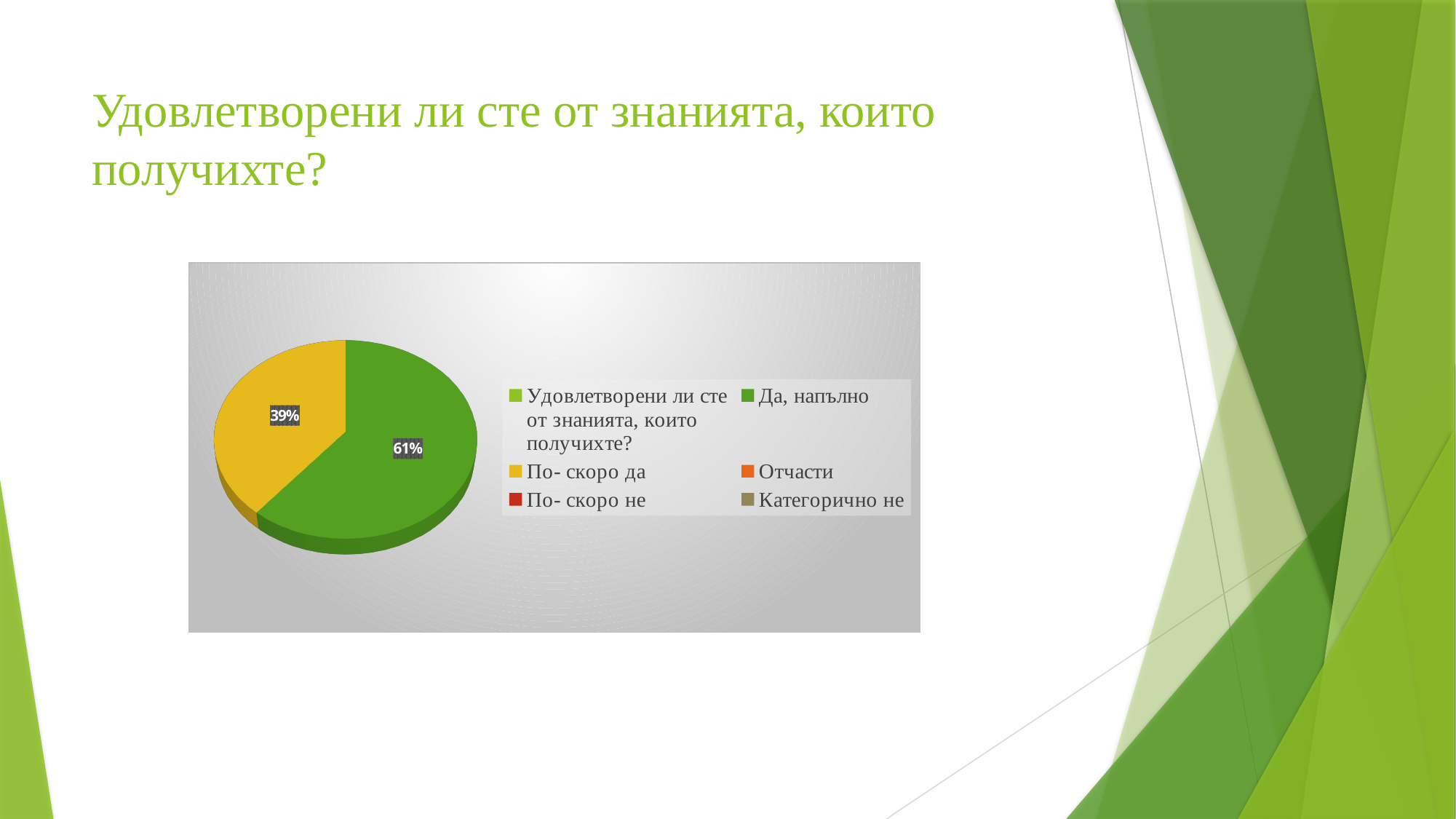
What is the difference in percentage points between the "Да, напълно" slice and the "По- скоро да" slice? 22 What kind of chart is shown on the slide? Pie chart Which category has the largest slice of the pie? Да, напълно What percentage of the pie is labelled for "По- скоро да"? 39% What colour is the "По- скоро да" slice? Yellow How many entries does the legend list? 6 What percentage of the pie is labelled for "Да, напълно"? 61% What share of the pie does the "Да, напълно" slice take? 61% What colour is the "Да, напълно" slice? Green Which is larger: the "Да, напълно" slice or the "По- скоро да" slice? Да, напълно Which of the two visible slices is the smaller one? По- скоро да How many slices are visible in the pie? 2